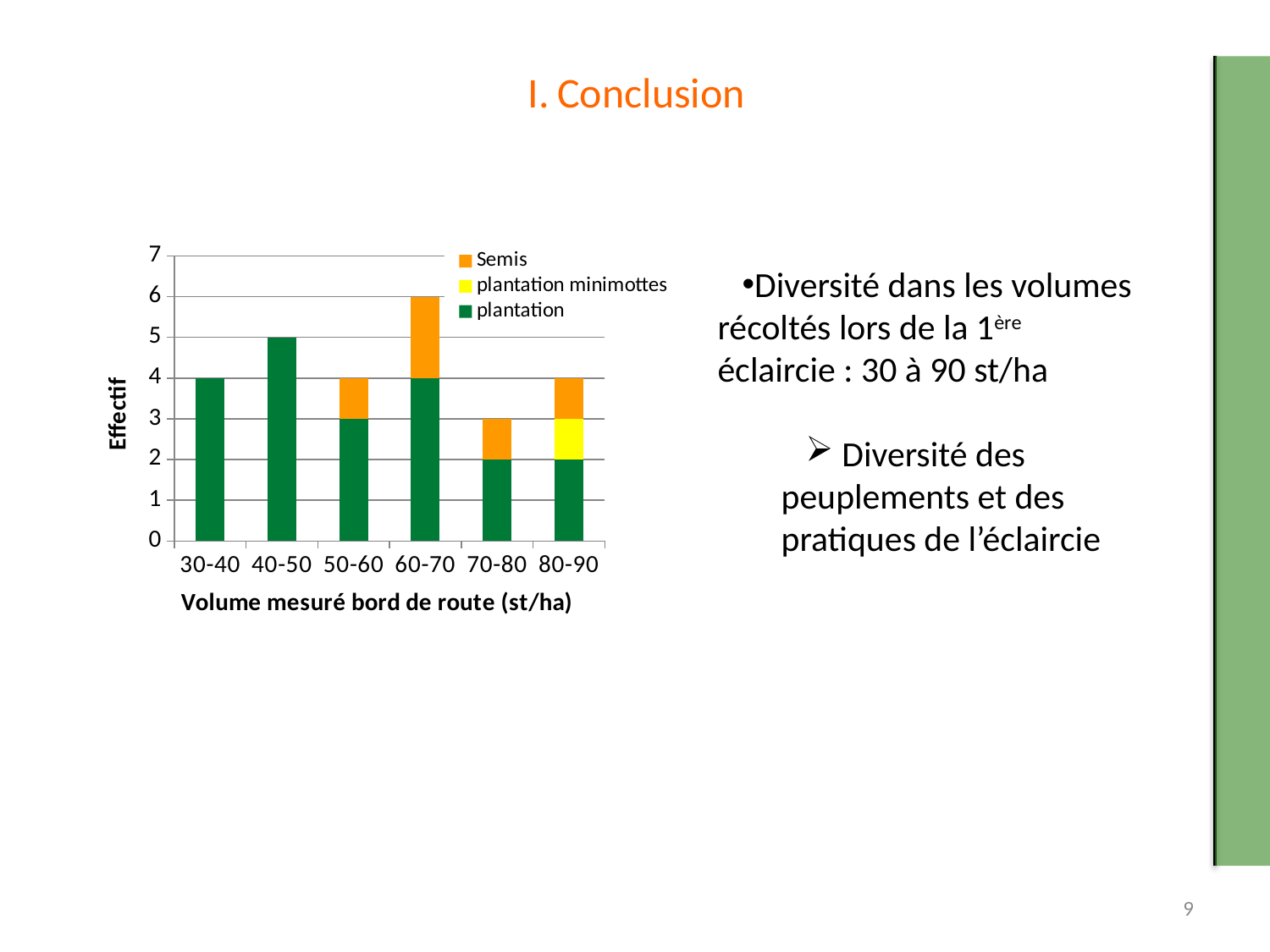
What is the plantation value for the 80-90 category? 2 Is the total for 40-50 larger than the total for 70-80? Yes What is the plantation value for the 40-50 category? 5 How many volume categories are shown on the x axis? 6 What is the total height of the stacked bar for 60-70? 6 How many series does the legend list? 3 What is the label of the x axis? Volume mesuré bord de route (st/ha) Which category is the only one with a plantation minimottes segment? 80-90 What is the total height of the stacked bar for 70-80? 3 Which volume category has the lowest total Effectif? 70-80 What kind of chart is shown on the slide? stacked bar chart Which volume category has the highest total Effectif? 60-70